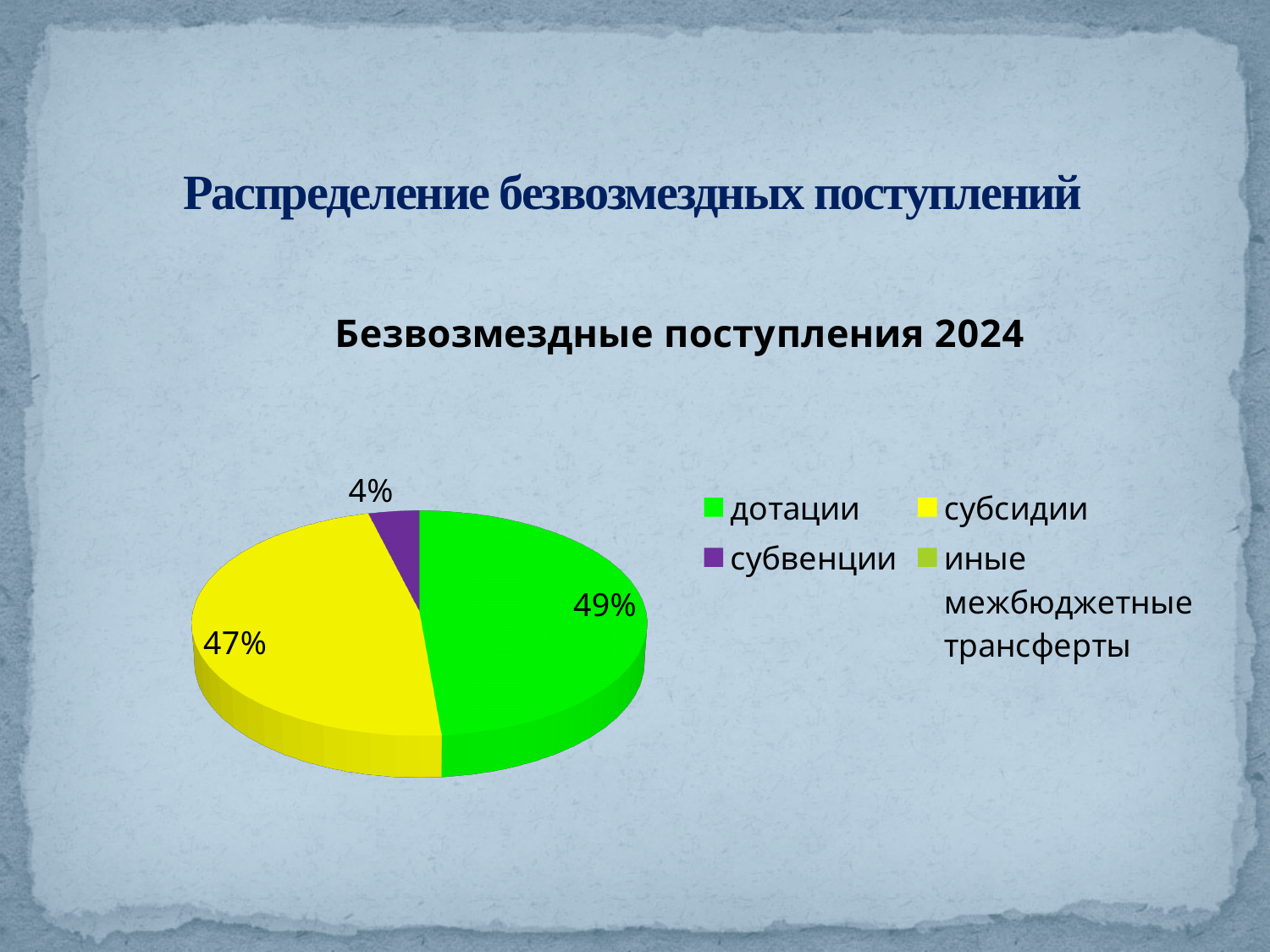
What is the combined share of дотации and субсидии? 96% What is the title of the chart? Безвозмездные поступления 2024 What share of the pie does субсидии have? 47% Which category has the largest share of the pie? дотации Which category with a visible slice has the smallest share of the pie? субвенции What type of chart is shown on the slide? pie chart What share of the pie does субвенции have? 4% Which is larger, the share for субсидии or the share for субвенции? субсидии What colour is the slice for субвенции? purple What is the difference in percentage points between дотации and субсидии? 2 What share of the pie does дотации have? 49% How many entries does the legend list? 4